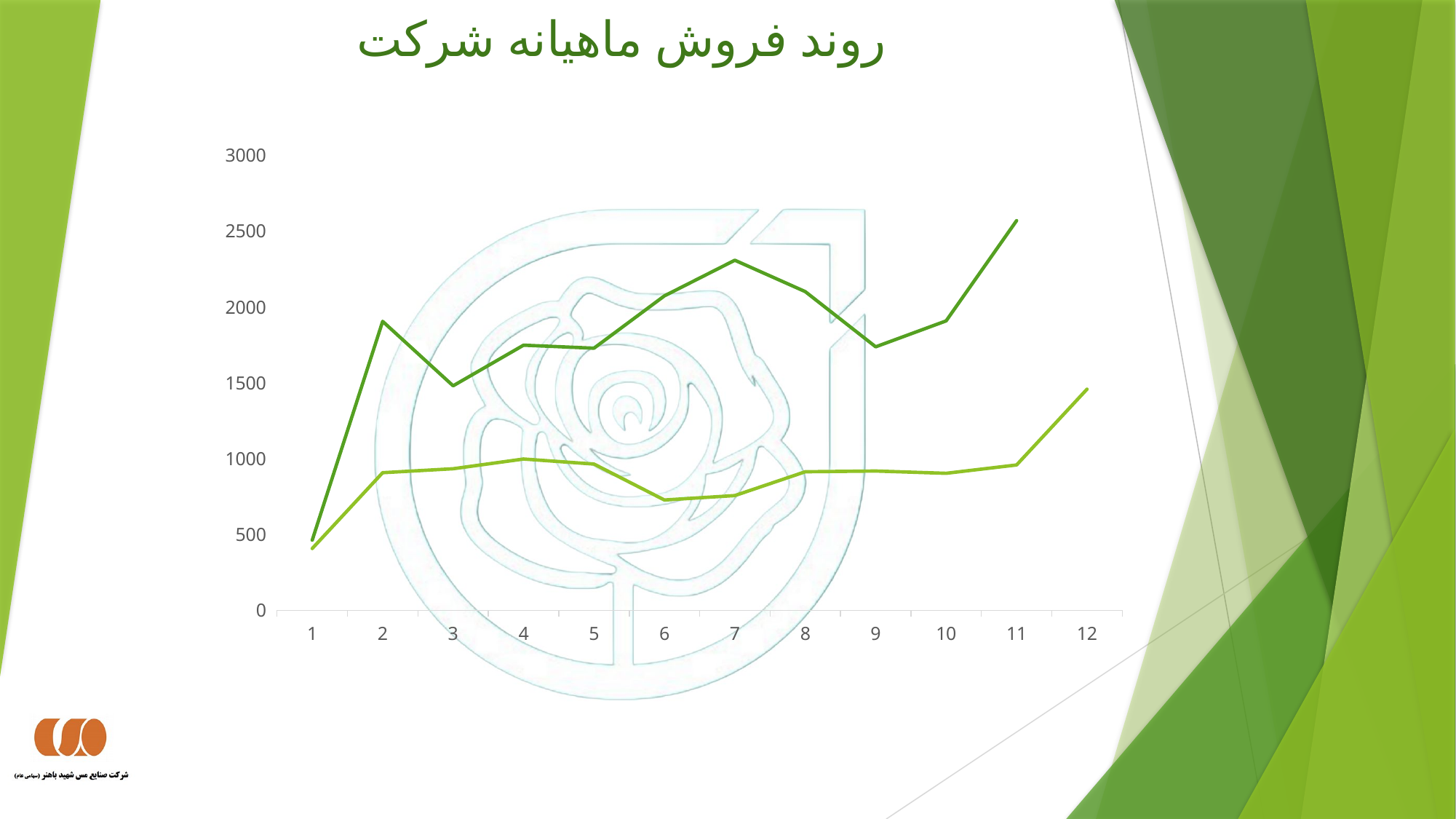
Is the value of the lighter green line at x = 12 greater or less than 1000? greater At x = 7, which line has the higher value, the darker green line or the lighter green line? the darker green line Is the value of the lighter green line at x = 6 greater or less than 1000? less At which x-axis category does the darker green line reach its highest value? 11 Is the value of the darker green line at x = 3 greater or less than 2000? less At which x-axis category does the lighter green line reach its highest value? 12 How many lines are plotted on the chart? 2 What kind of chart is shown on the slide? line chart What is the highest value shown on the y axis? 3000 How many categories are labelled along the x axis? 12 Does the darker green line rise or fall between x = 7 and x = 9? fall